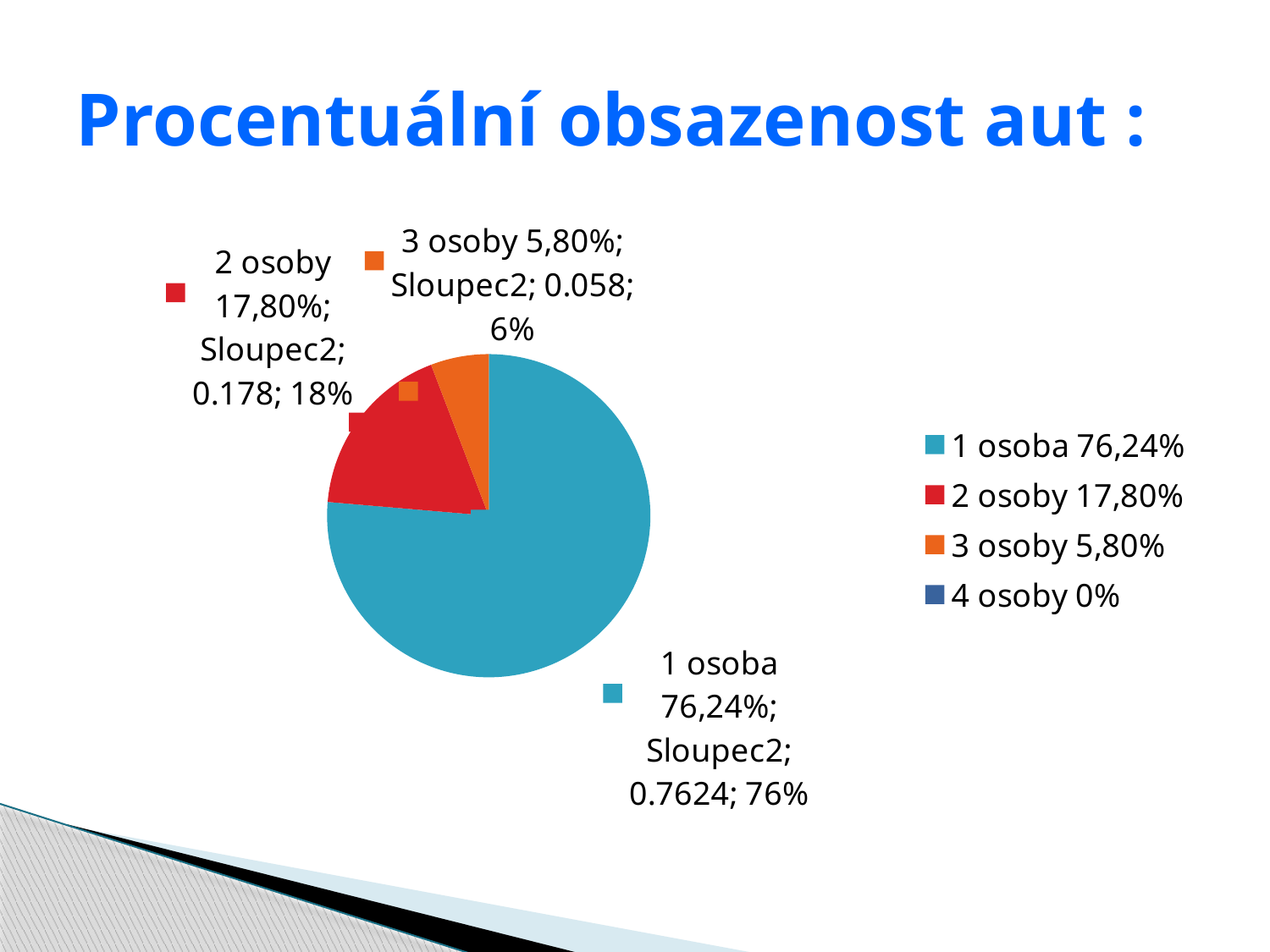
What share of the pie does the '1 osoba' slice represent, according to its data label? 76% Which category has the largest slice of the pie chart? 1 osoba What is the plotted value for the '3 osoby' slice of the pie chart? 0.058 Which slice is larger in the pie chart: '2 osoby' or '3 osoby'? 2 osoby What is the plotted value for the '1 osoba' slice of the pie chart? 0.7624 Which category has the smallest non-zero slice of the pie chart? 3 osoby What is the title of the slide containing the pie chart? Procentuální obsazenost aut : What share of the pie does the '2 osoby' slice represent, according to its data label? 18% What is the difference between the plotted values for '1 osoba' (0.7624) and '2 osoby' (0.178)? 0.5844 How many categories does the legend of the pie chart list? 4 What kind of chart is shown on the slide? pie chart What is the plotted value for the '2 osoby' slice of the pie chart? 0.178